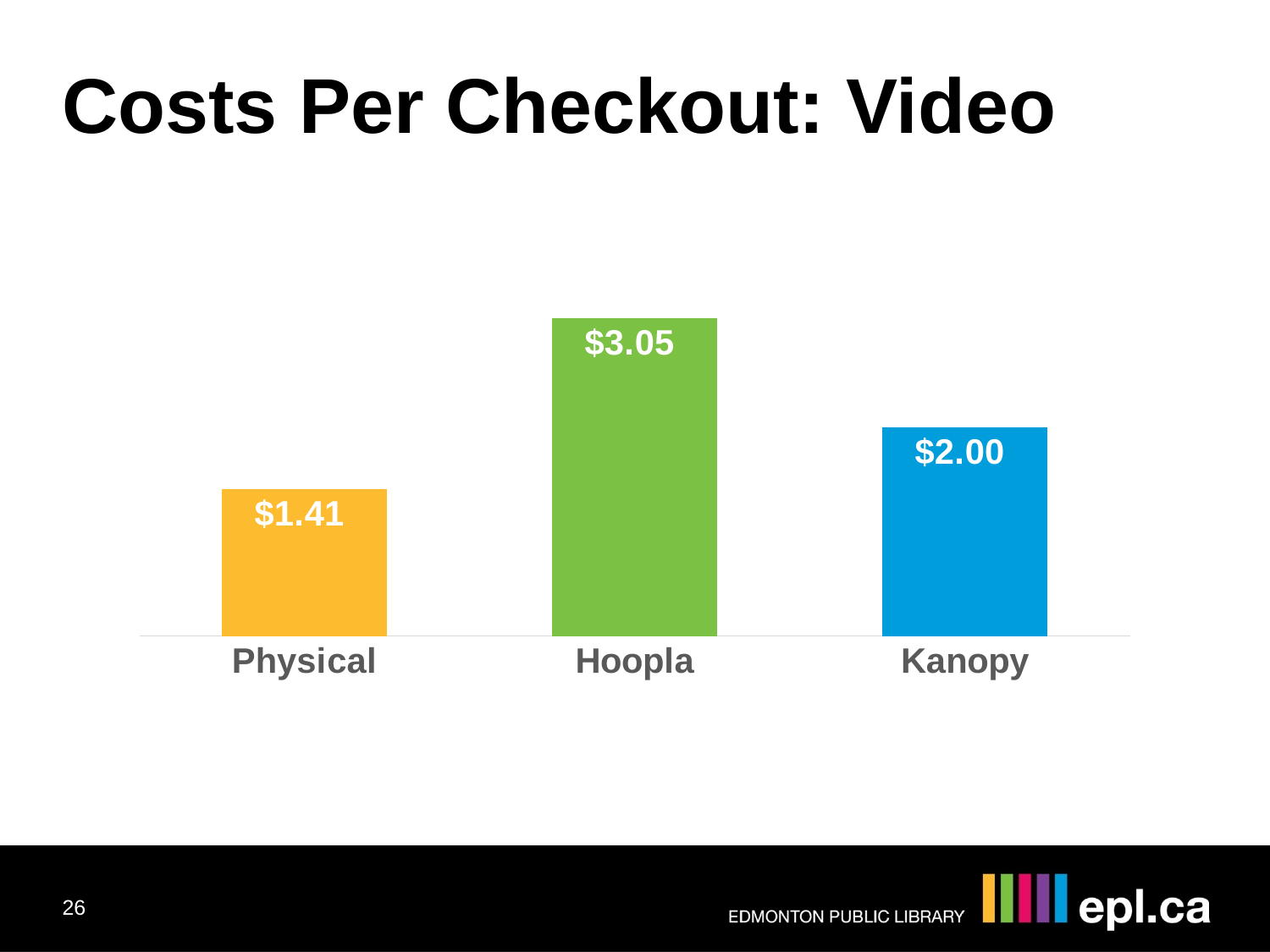
How many categories are shown in the chart? 3 What is the cost per checkout for Physical video? $1.41 What is the difference in cost per checkout between Kanopy and Physical? $0.59 What is the cost per checkout for Hoopla? $3.05 Which category has the highest cost per checkout? Hoopla What is the cost per checkout for Kanopy? $2.00 Which has a higher cost per checkout, Kanopy or Physical? Kanopy Which category has the lowest cost per checkout? Physical What is the difference in cost per checkout between Hoopla and Physical? $1.64 What is the title of the slide containing the chart? Costs Per Checkout: Video What is the difference in cost per checkout between Hoopla and Kanopy? $1.05 What kind of chart is shown on the slide? Bar chart